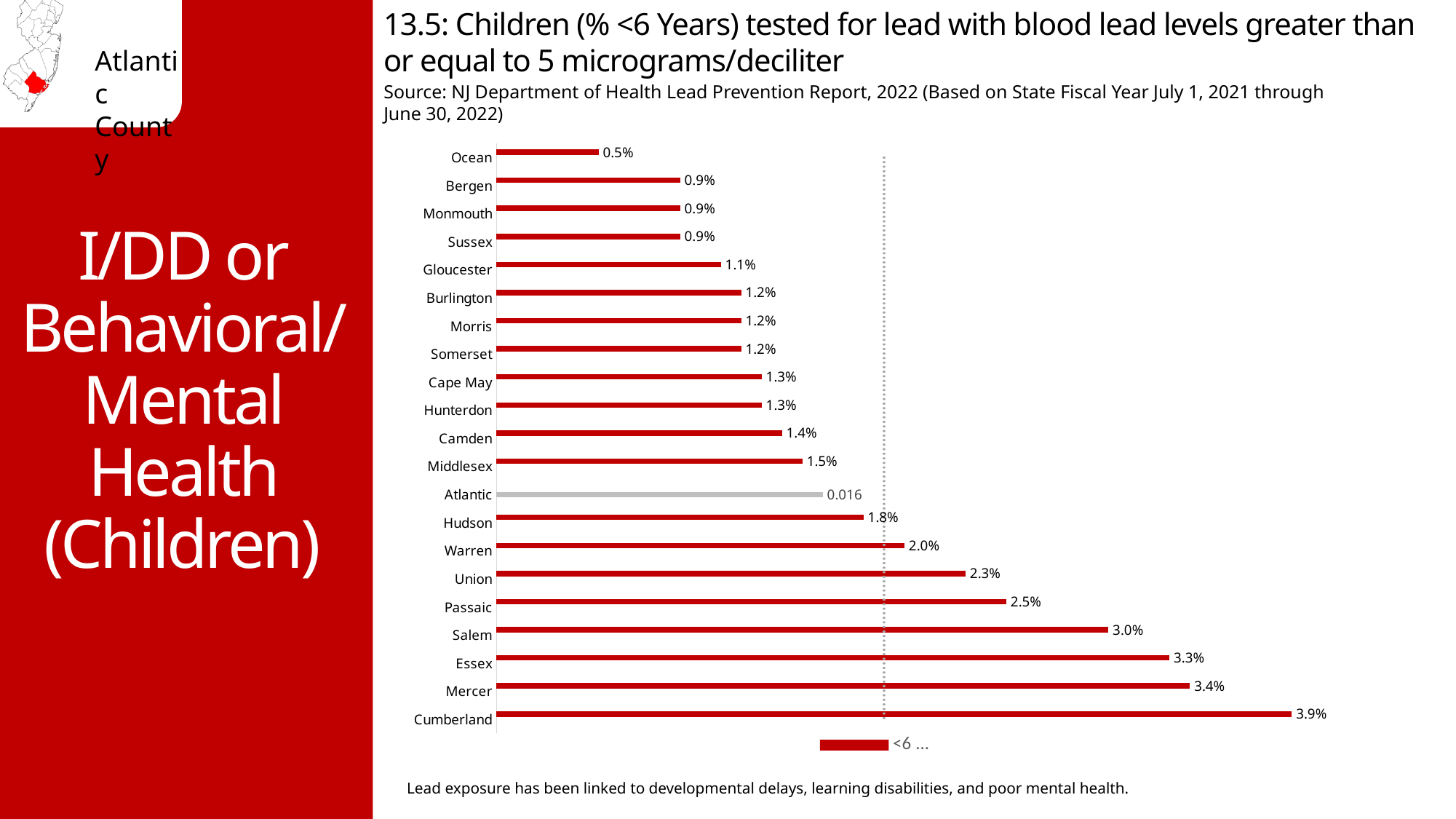
What value is labeled on the Atlantic bar? 0.016 Which is larger, the value for Salem or the value for Union? Salem What is the value for Ocean? 0.5% What is the value for Cumberland? 3.9% What kind of chart is this? Bar chart Which county's bar is shown in gray instead of red? Atlantic How many counties are shown in the chart? 21 What is the value for Passaic? 2.5% Which county has the highest value? Cumberland What is the difference between the values for Cumberland and Ocean? 3.4% What is the difference between the values for Mercer and Essex? 0.1% Which county has the lowest value? Ocean